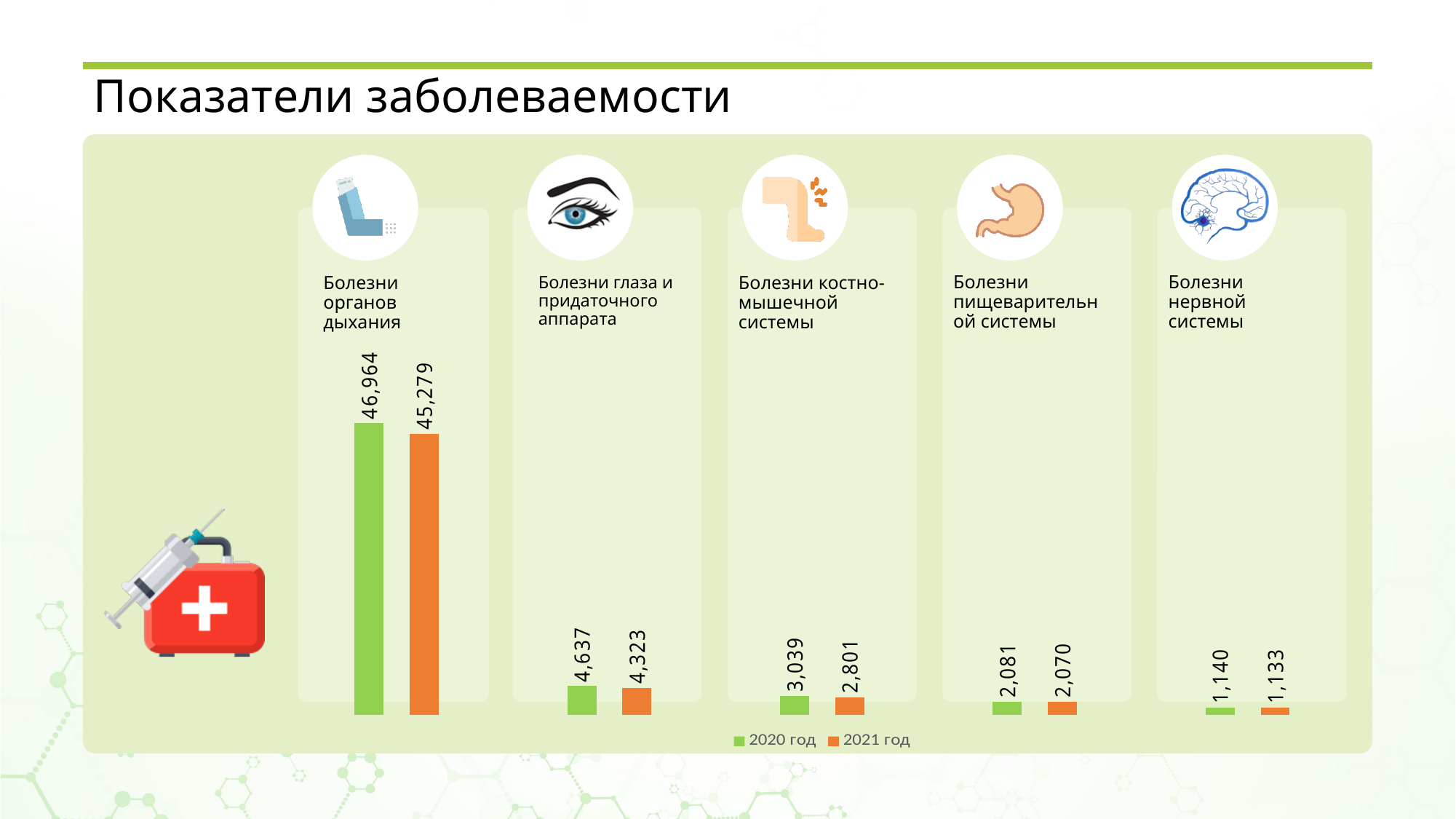
How many disease categories are shown in the chart? 5 What is the 2020 год value for Болезни органов дыхания? 46,964 What is the 2021 год value for Болезни нервной системы? 1,133 Which category has the lowest 2020 год value? Болезни нервной системы Which is larger for Болезни органов дыхания: the 2020 год value or the 2021 год value? 2020 год What is the difference between the 2020 год and 2021 год values for Болезни органов дыхания? 1,685 What is the difference between the 2020 год and 2021 год values for Болезни пищеварительной системы? 11 What is the 2021 год value for Болезни глаза и придаточного аппарата? 4,323 Which category has the highest 2021 год value? Болезни органов дыхания What is the 2020 год value for Болезни костно-мышечной системы? 3,039 What type of chart is shown on the slide? Bar chart How many series does the legend list? 2